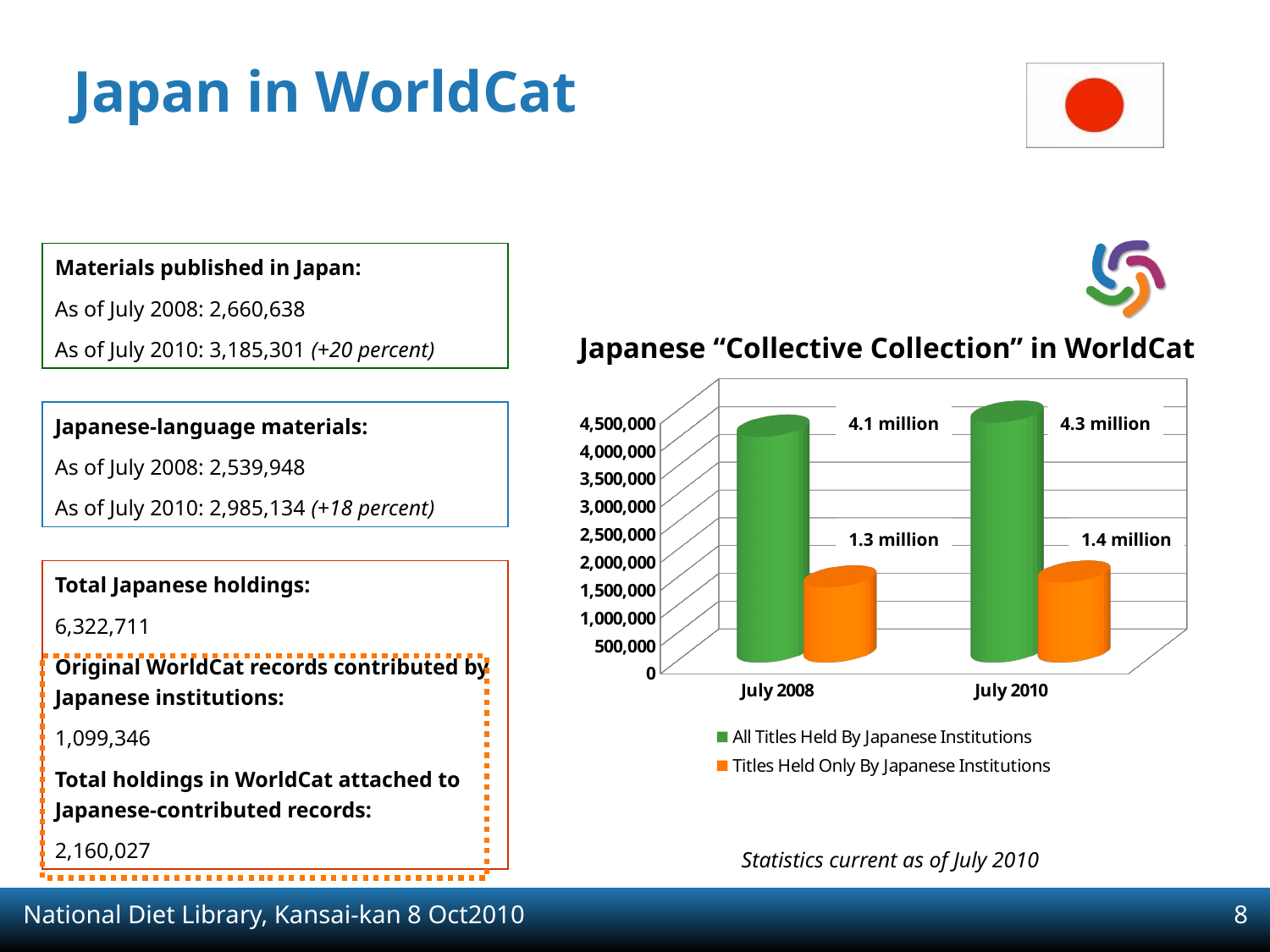
Is the value for Titles Held Only By Japanese Institutions in July 2010 greater or less than 2,000,000? less How many series does the legend list? 2 What is the value for Titles Held Only By Japanese Institutions in July 2010? 1.4 million Which series has the lower value in July 2010? Titles Held Only By Japanese Institutions What is the value for All Titles Held By Japanese Institutions in July 2008? 4.1 million What kind of chart is shown on the slide? bar chart What is the value for Titles Held Only By Japanese Institutions in July 2008? 1.3 million What is the title of the chart? Japanese "Collective Collection" in WorldCat What is the value for All Titles Held By Japanese Institutions in July 2010? 4.3 million Which category has the higher value for All Titles Held By Japanese Institutions, July 2008 or July 2010? July 2010 How many categories are shown on the x axis? 2